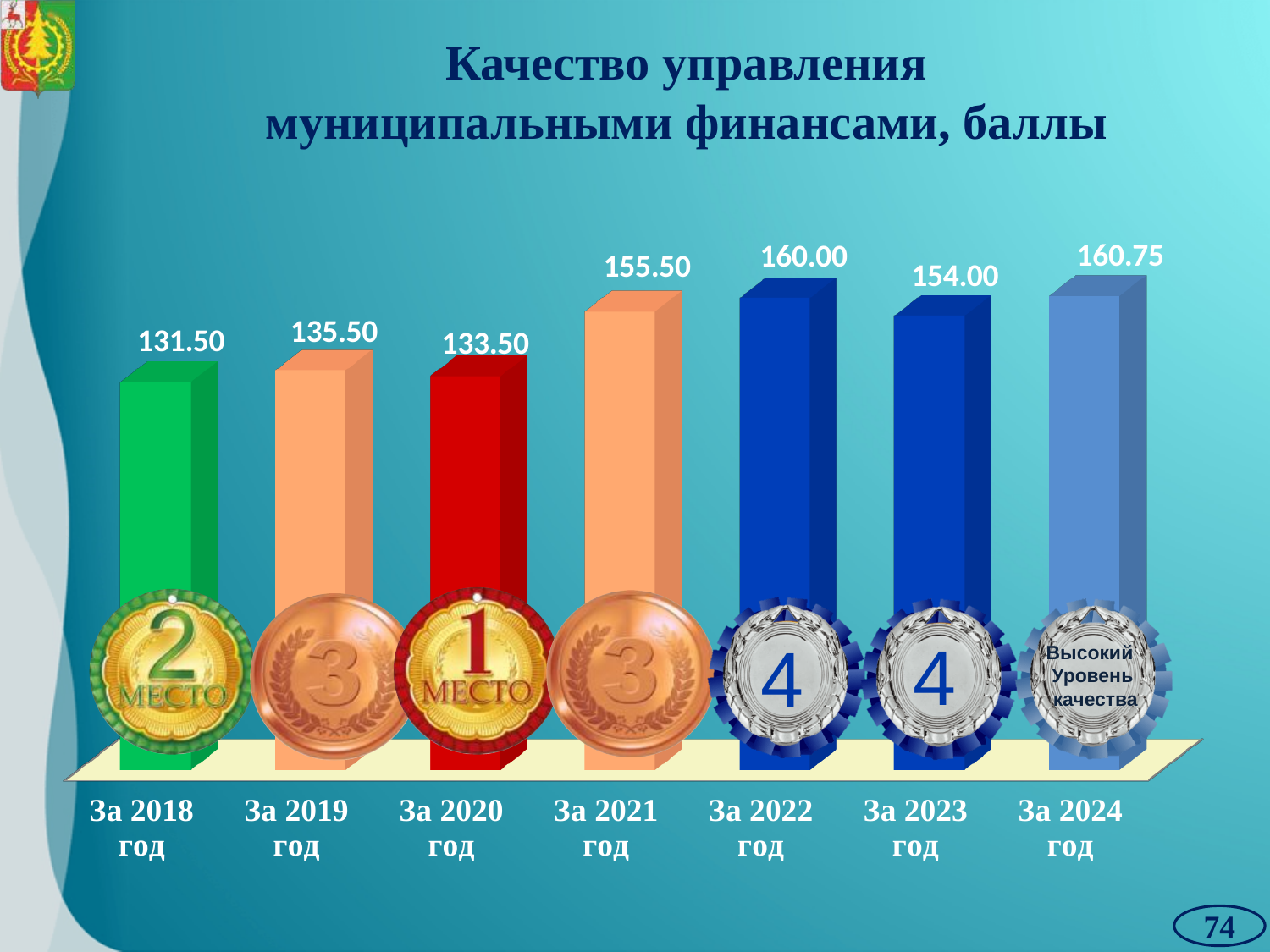
What is the difference between the values for За 2022 год and За 2023 год? 6.00 Which year has the highest value? За 2024 год What is the value for За 2021 год? 155.50 Is the value for За 2022 год greater or less than the value for За 2021 год? greater What kind of chart is this? bar chart How many years are shown on the chart? 7 What is the value for За 2023 год? 154.00 Which year has the lowest value? За 2018 год Which is larger, the value for За 2019 год or За 2020 год? За 2019 год What is the title of the chart? Качество управления муниципальными финансами, баллы What is the value for За 2018 год? 131.50 What is the difference between the values for За 2024 год and За 2018 год? 29.25